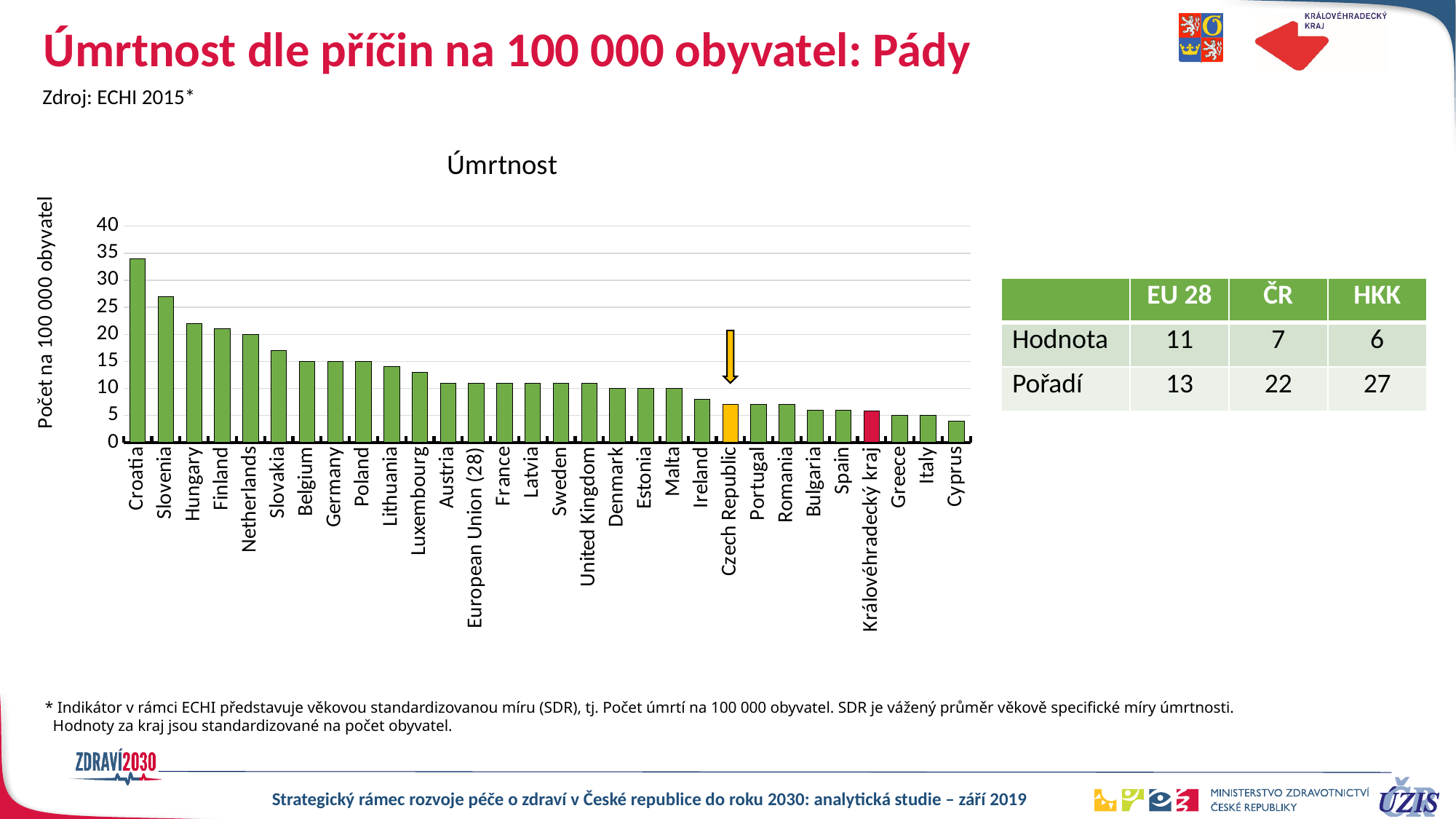
Which category has the lowest value in the chart? Cyprus What kind of chart is shown on the slide? bar chart Do the values rise or fall from left to right along the x axis? fall According to the table, what is the value (Hodnota) for ČR? 7 Which country has the highest value in the chart? Croatia Is the value for Cyprus greater or less than 5? less According to the table, what is the difference between the value for EU 28 and the value for ČR? 4 Which is larger, the value for Croatia or the value for Slovenia? Croatia What colour is the bar for Czech Republic? orange How many bars (categories) are plotted in the chart? 30 Is the value for Croatia greater or less than 30? greater